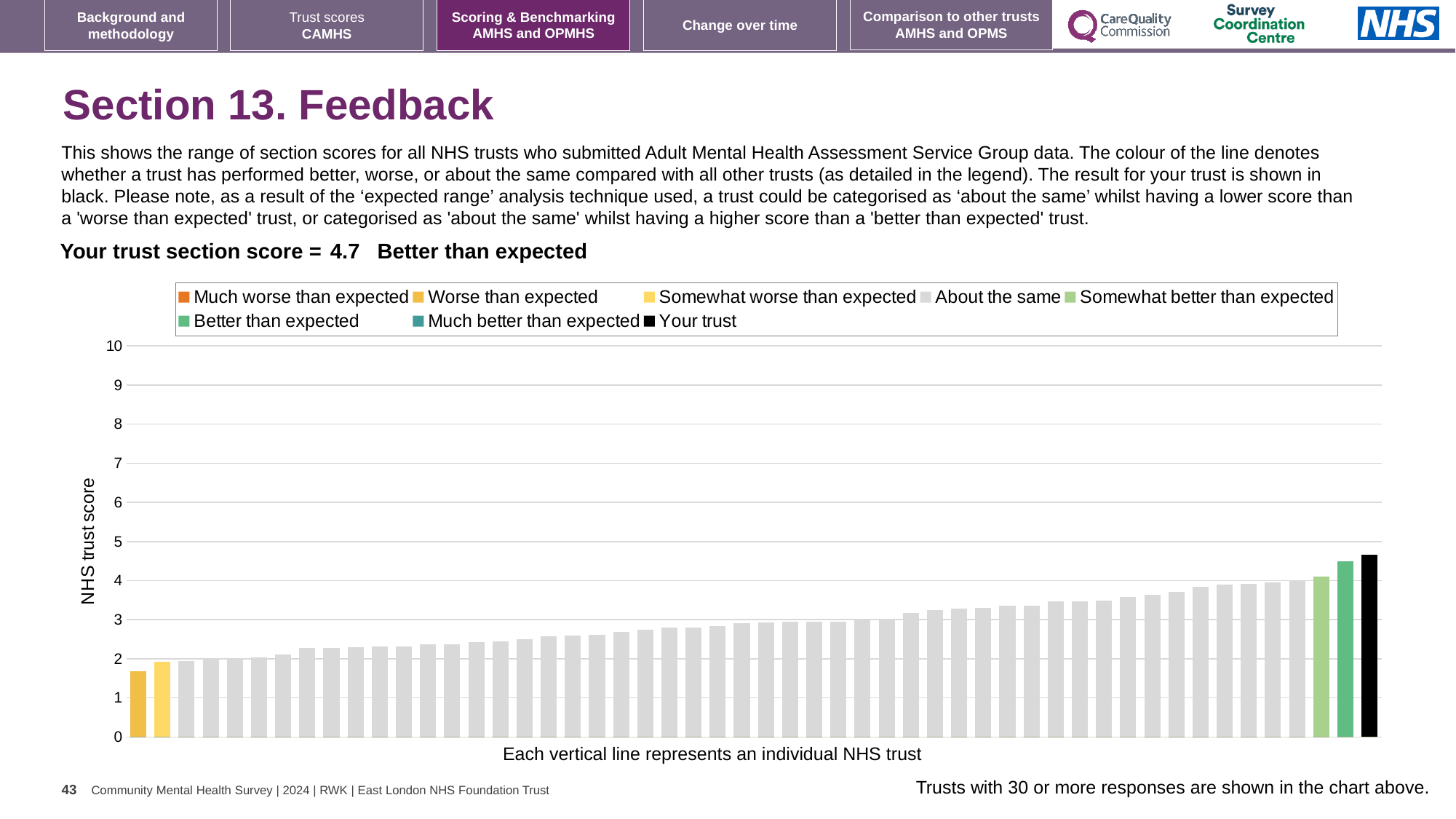
Which category does the tallest bar in the chart belong to? Your trust Do the bar values rise or fall from left to right along the x axis? rise How many entries does the chart legend list? 8 Is the value for the leftmost bar greater or less than 2? less Is the value for the highest bar in the chart greater or less than 5? less What is the section score for your trust? 4.7 What is the label on the y axis of the chart? NHS trust score Which is larger, the Your trust bar or the leftmost bar? Your trust What colour is the bar representing your trust? black How many bars in the chart are not coloured grey (About the same)? 5 Is the value for the Your trust bar greater or less than 4? greater What kind of chart is shown on the slide? bar chart